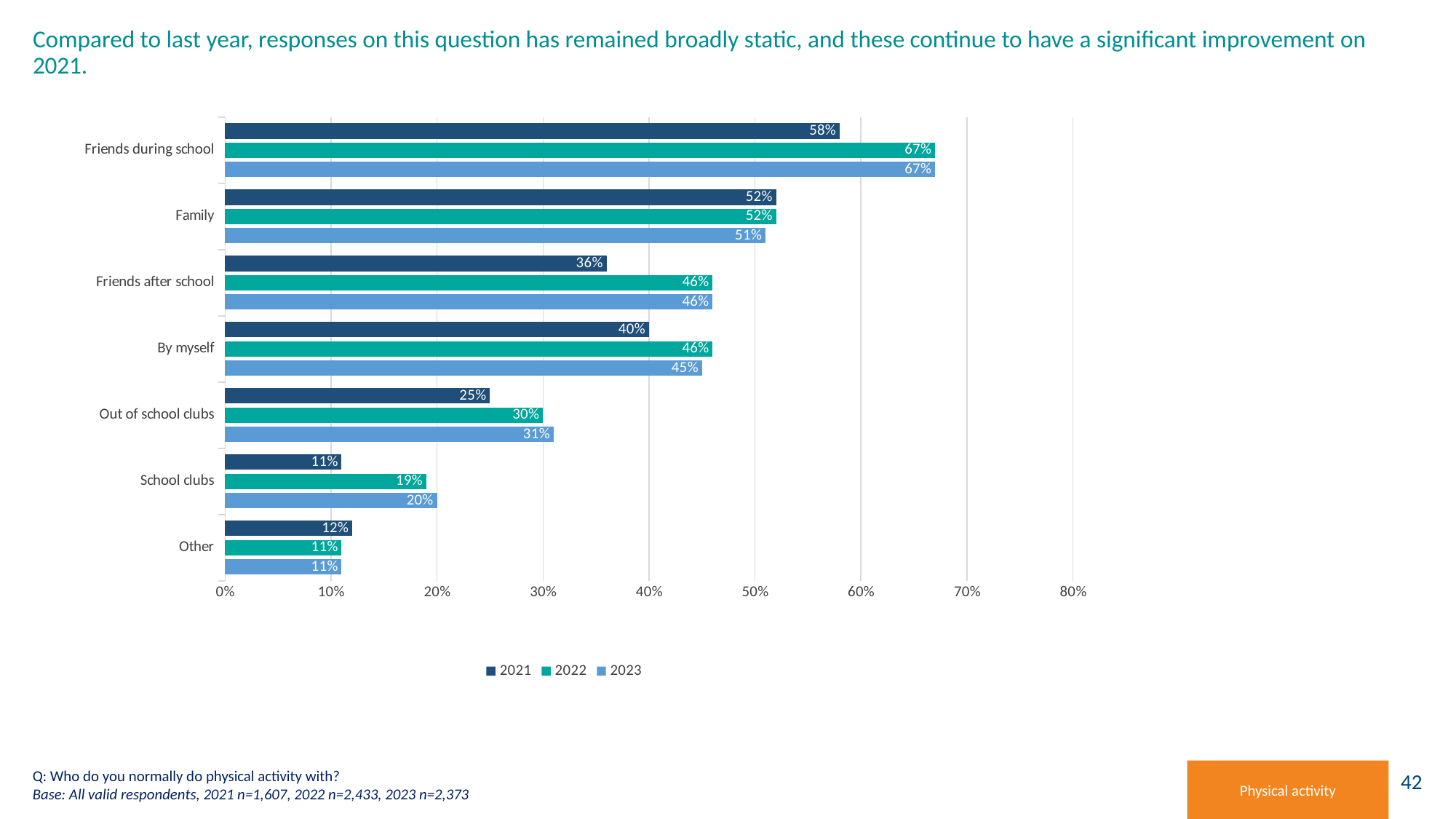
Which is larger: the 2021 value for By myself or the 2021 value for Friends after school? By myself What is the 2023 value for Friends during school? 67% How many series does the legend list? 3 Which category has the highest 2023 value? Friends during school What is the difference between the 2023 and 2021 values for Out of school clubs? 6% Which series does the legend list first? 2021 What is the difference between the 2022 and 2021 values for Friends after school? 10% Which category has the lowest 2021 value? School clubs What is the 2021 value for Friends after school? 36% What kind of chart is shown on the slide? Bar chart What is the 2022 value for School clubs? 19% How many categories are shown on the chart? 7